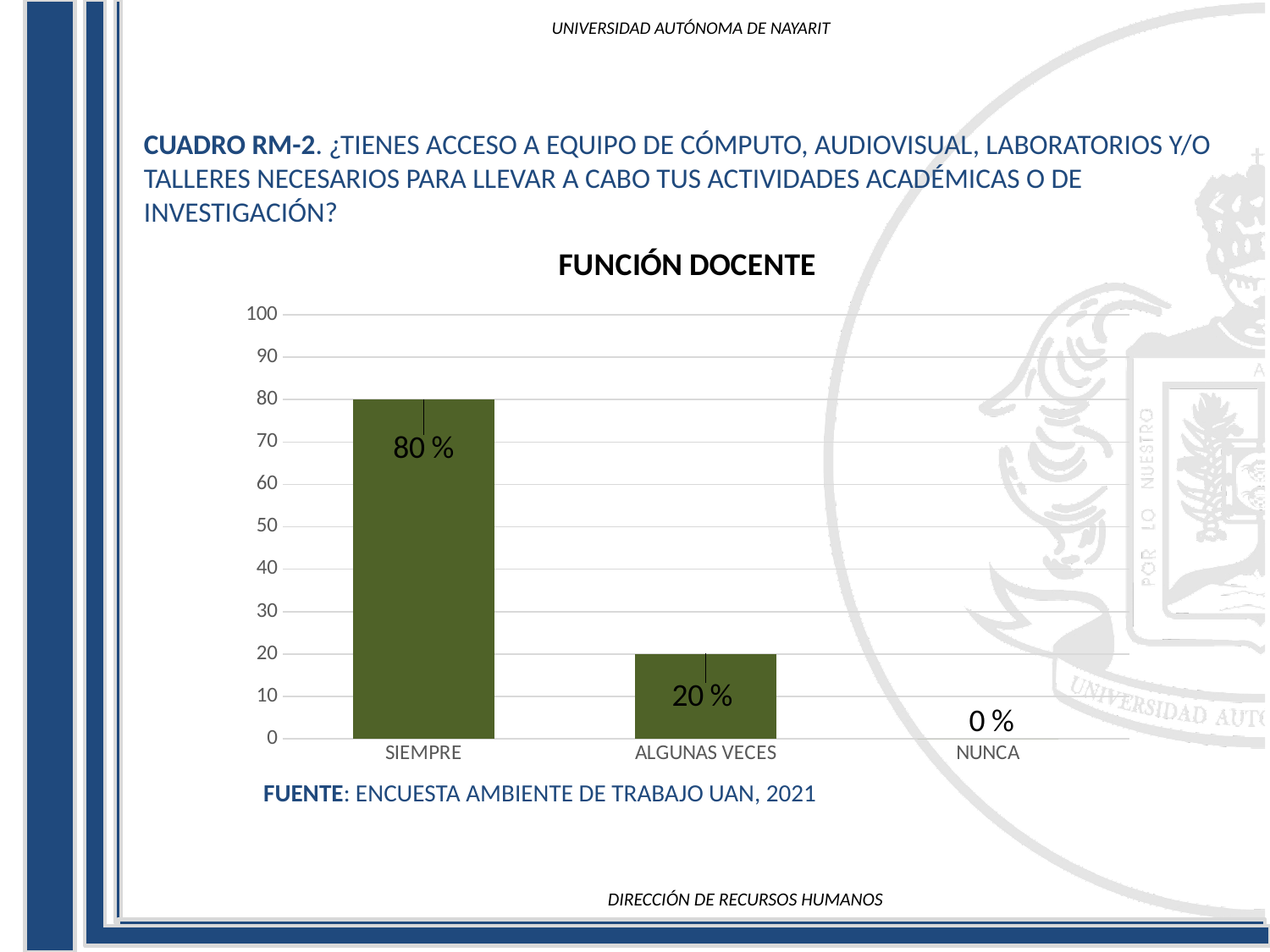
Do the values rise or fall from left to right along the x axis? fall What is the title of the chart? FUNCIÓN DOCENTE Is the value for SIEMPRE greater or less than 50? greater What is the value for NUNCA? 0 % Which category has the highest value? SIEMPRE Which is larger, the value for ALGUNAS VECES or the value for NUNCA? ALGUNAS VECES What is the value for SIEMPRE? 80 % What is the difference between the values for SIEMPRE and ALGUNAS VECES? 60 % What kind of chart is shown? bar chart Which category has the lowest value? NUNCA How many categories are shown on the x axis? 3 What is the value for ALGUNAS VECES? 20 %